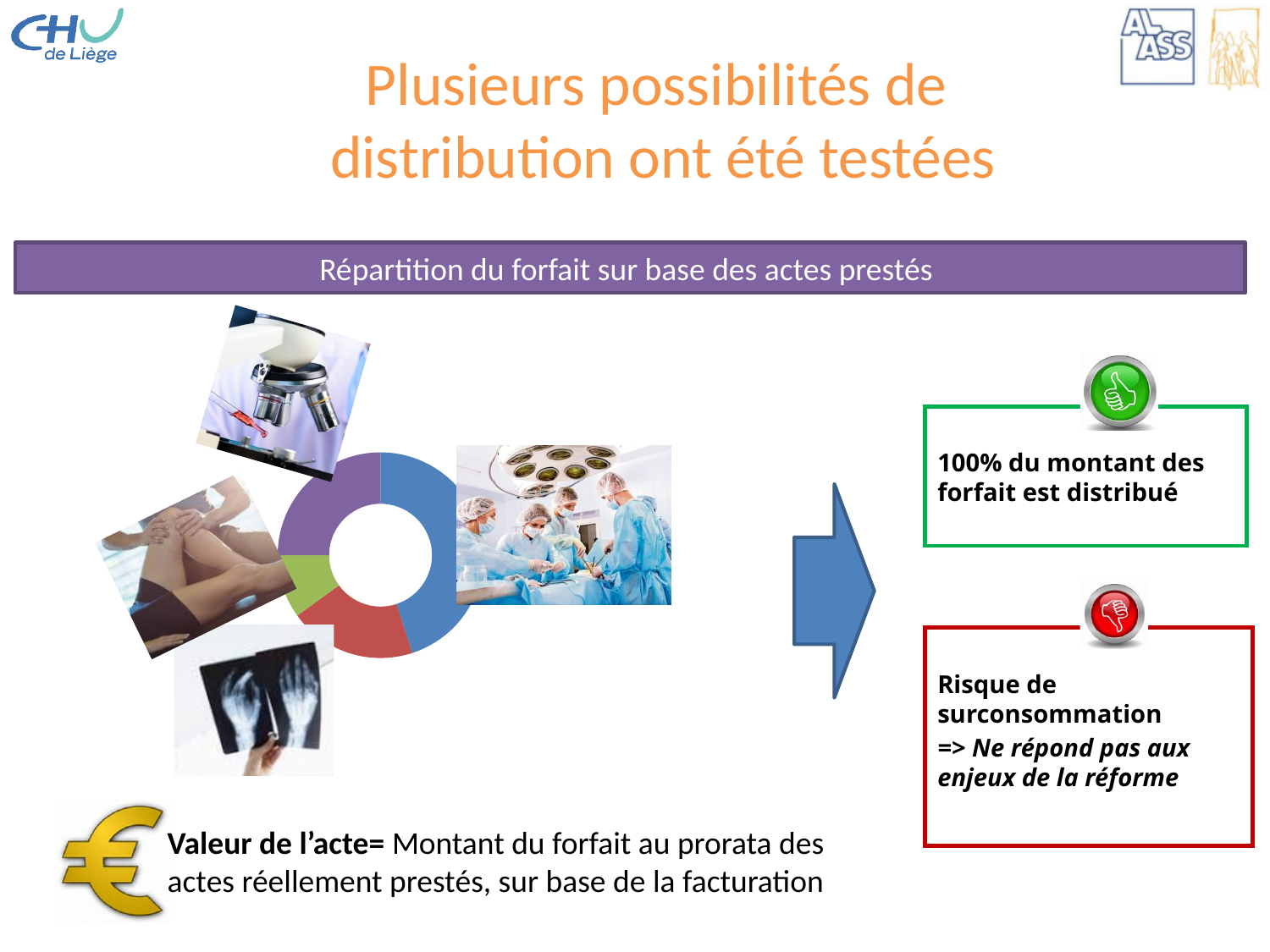
Does the donut chart display data labels with values? No How many slices does the donut chart have? 4 Which slice is larger in the donut chart, the blue one or the purple one? Blue Which slice is larger in the donut chart, the red one or the green one? Red What kind of chart is shown on the slide? Pie chart (donut) Which colour slice is the smallest in the donut chart? Green Does the donut chart have a legend? No Which colour slice is the largest in the donut chart? Blue